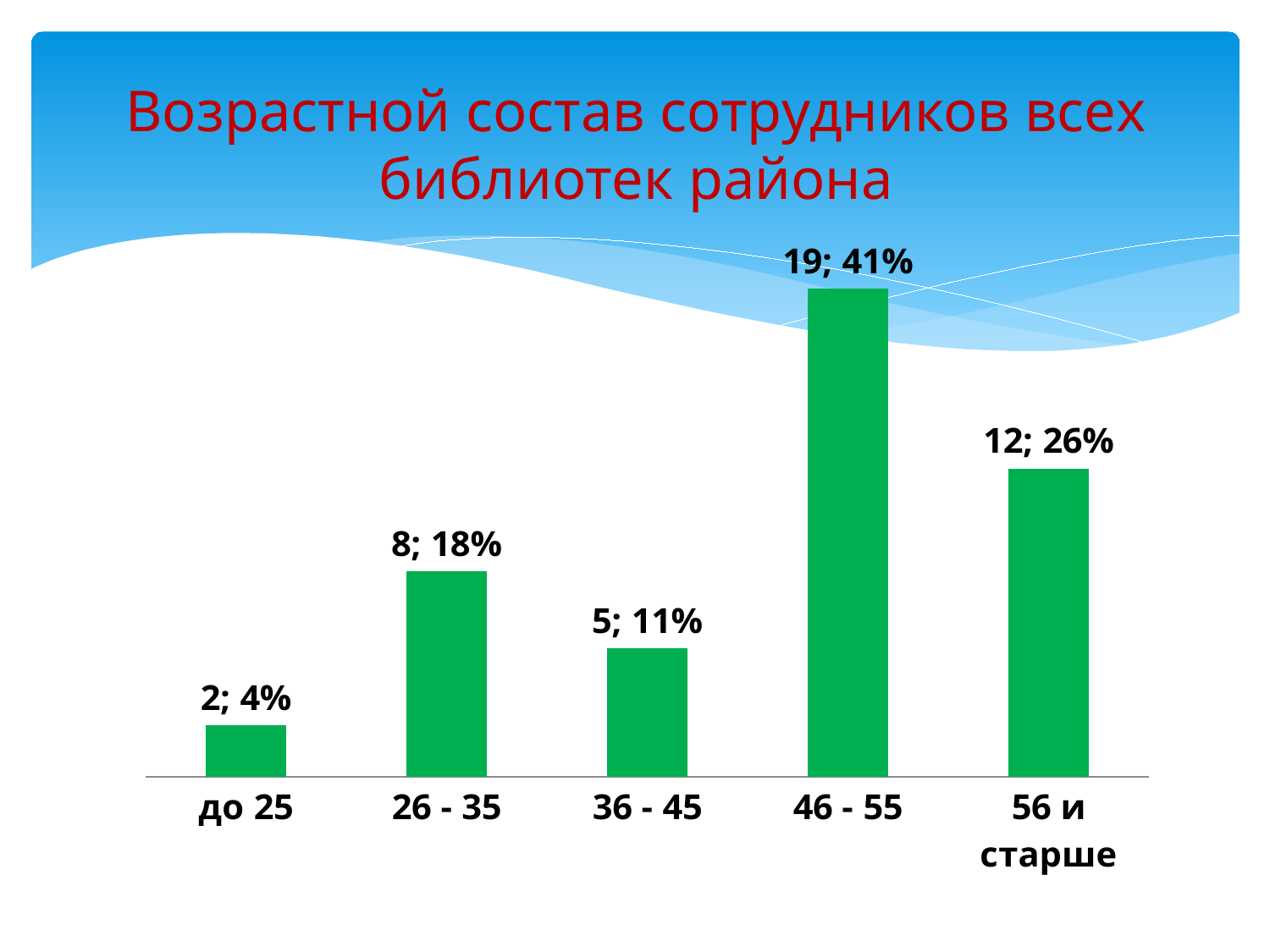
What is the difference in employee count between the '46 - 55' and '56 и старше' groups? 7 Which age group has the highest value? 46 - 55 How many employees are in the 'до 25' age group? 2 How many age categories are shown on the chart? 5 What is the data label shown for the '46 - 55' category? 19; 41% What is the total number of employees across all five age groups? 46 Which age group has the lowest value? до 25 What type of chart is shown on the slide? Bar chart What is the title of the chart on the slide? Возрастной состав сотрудников всех библиотек района Which has a larger value, '26 - 35' or '36 - 45'? 26 - 35 What is the data label for the '56 и старше' category? 12; 26% What percentage is shown for the '26 - 35' age group? 18%